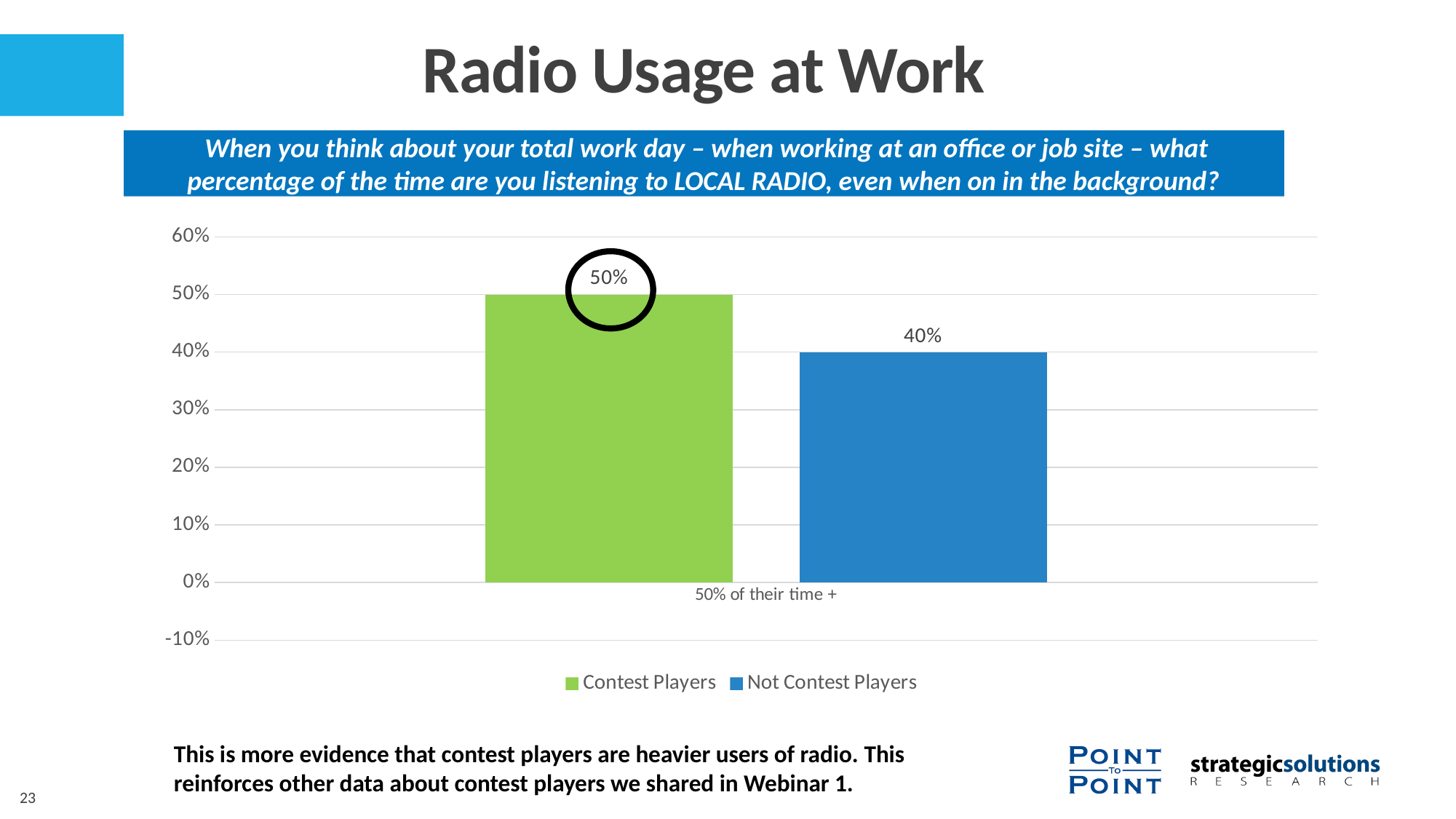
How many series does the legend list? 2 How many bars are plotted in the chart? 2 What is the category label shown on the x axis? 50% of their time + Is the value for Contest Players greater or less than 40%? greater What kind of chart is shown on the slide? bar chart What is the difference between the Contest Players value and the Not Contest Players value? 10% What is the value for Not Contest Players? 40% Which series has the higher value, Contest Players or Not Contest Players? Contest Players What colour is the bar for Contest Players? green What is the value for Contest Players? 50% Which series has the lowest value? Not Contest Players Is the value for Not Contest Players greater or less than 50%? less